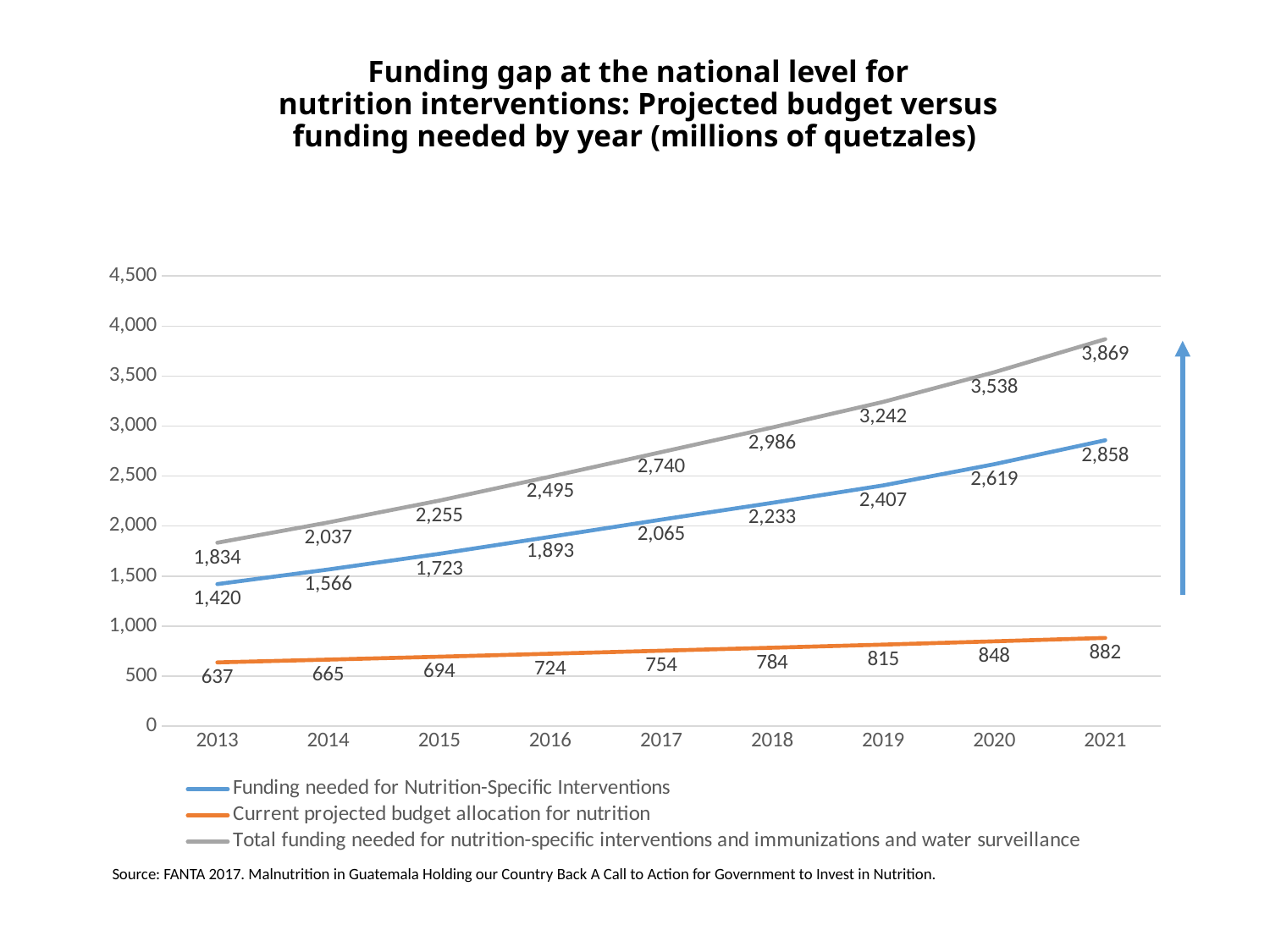
What kind of chart is shown on the slide? Line chart Which is larger in 2019: Funding needed for Nutrition-Specific Interventions or Current projected budget allocation for nutrition? Funding needed for Nutrition-Specific Interventions In which year is the Total funding needed for nutrition-specific interventions and immunizations and water surveillance highest? 2021 How many years are shown on the x axis? 9 How many series does the legend list? 3 What is the difference between Total funding needed and Funding needed for Nutrition-Specific Interventions in 2021? 1,011 Does the Current projected budget allocation for nutrition rise or fall from 2013 to 2021? Rise In which year is the Funding needed for Nutrition-Specific Interventions lowest? 2013 What is the value for Funding needed for Nutrition-Specific Interventions in 2017? 2,065 What is the value for Total funding needed for nutrition-specific interventions and immunizations and water surveillance in 2021? 3,869 What is the difference between Funding needed for Nutrition-Specific Interventions and Current projected budget allocation for nutrition in 2013? 783 What is the value for Current projected budget allocation for nutrition in 2013? 637